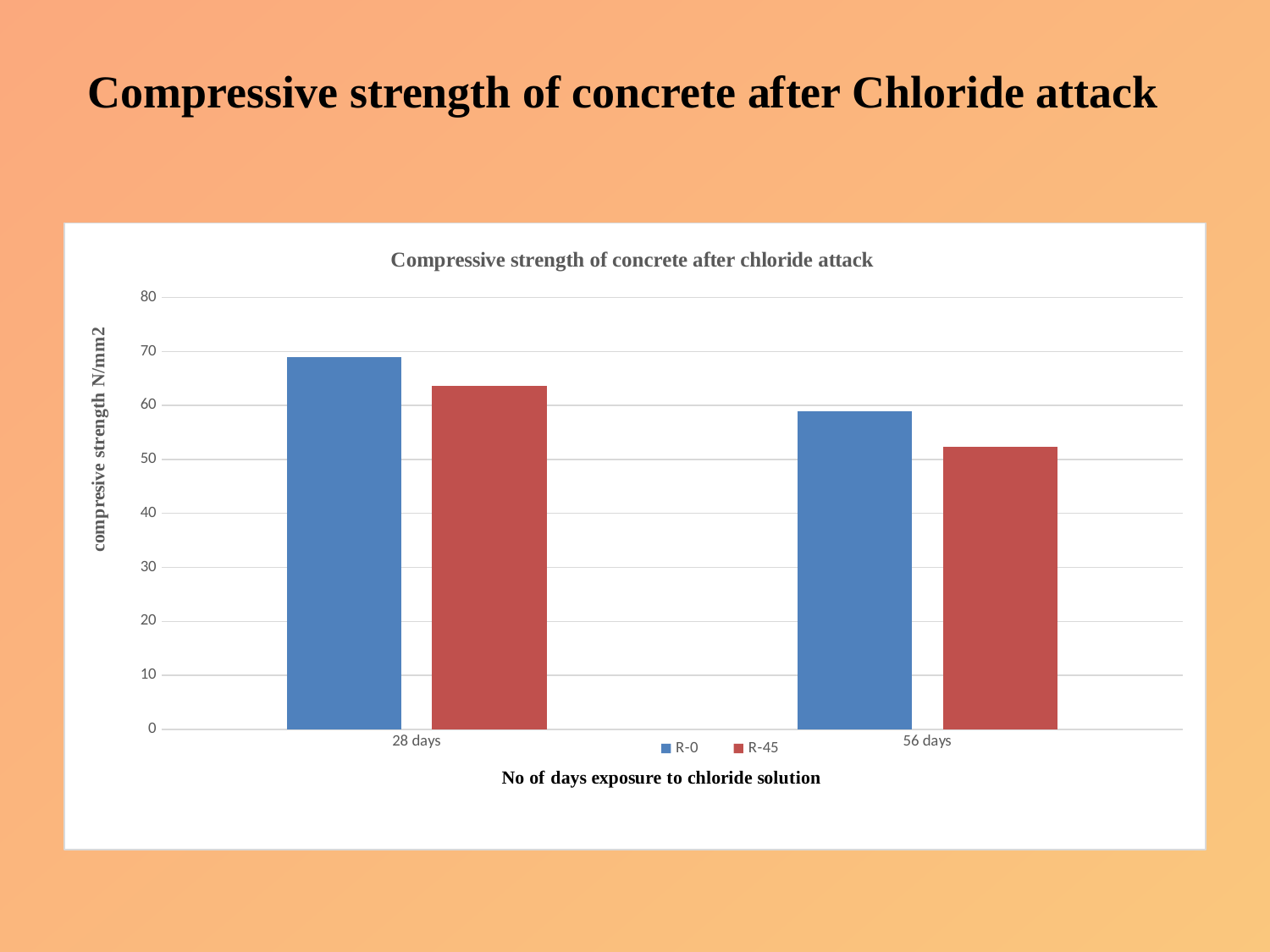
What is the title of the chart? Compressive strength of concrete after chloride attack Is the value for R-0 at 28 days greater or less than 60? greater Which bar is the lowest in the chart? R-45 at 56 days Is the value for R-0 at 56 days greater or less than 50? greater How many categories are shown on the x axis? 2 Is the value for R-45 at 28 days greater or less than 70? less What is the label of the x axis? No of days exposure to chloride solution How many series does the legend list? 2 What kind of chart is shown on the slide? bar chart Do the values for R-0 rise or fall from 28 days to 56 days? fall Which series has the higher value at 28 days, R-0 or R-45? R-0